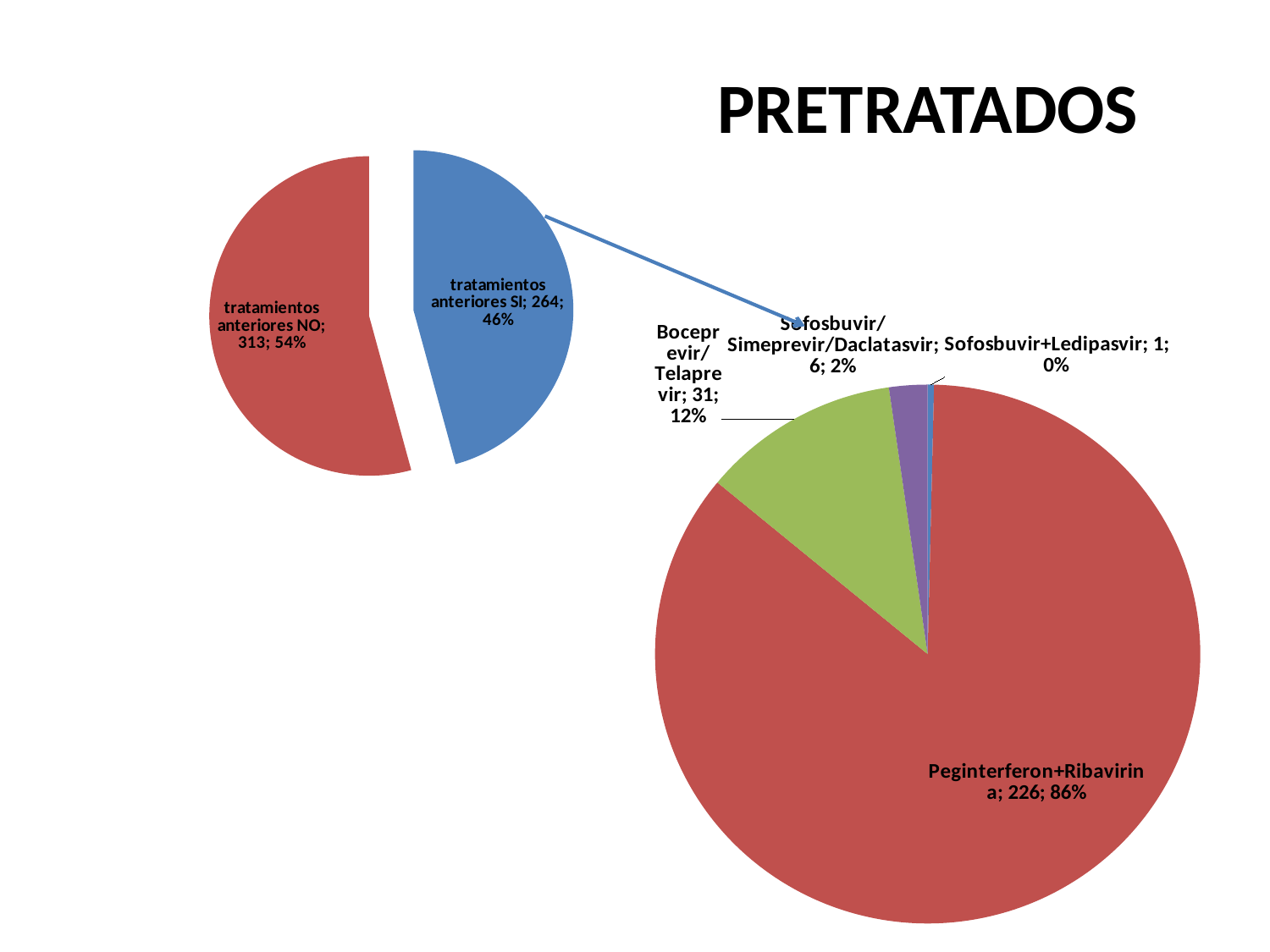
How many slices does the pie chart on the right have? 4 What type of chart is shown on the left of the slide? Pie chart In the pie chart on the right, which category has the largest value? Peginterferon+Ribavirina In the pie chart on the left, what is the difference between the values for 'tratamientos anteriores NO' and 'tratamientos anteriores SI'? 49 In the pie chart on the right, what is the difference between the values for 'Peginterferon+Ribavirina' and 'Boceprevir/Telaprevir'? 195 In the pie chart on the right, which category has the smallest value? Sofosbuvir+Ledipasvir In the pie chart on the left, what is the value for 'tratamientos anteriores NO'? 313 In the pie chart on the left, what percentage share does 'tratamientos anteriores SI' have? 46% In the pie chart on the right, what is the value for 'Peginterferon+Ribavirina'? 226 In the pie chart on the right, what percentage share does 'Boceprevir/Telaprevir' have? 12% In the pie chart on the right, what is the value for 'Sofosbuvir/Simeprevir/Daclatasvir'? 6 In the pie chart on the left, which category is larger, 'tratamientos anteriores NO' or 'tratamientos anteriores SI'? tratamientos anteriores NO